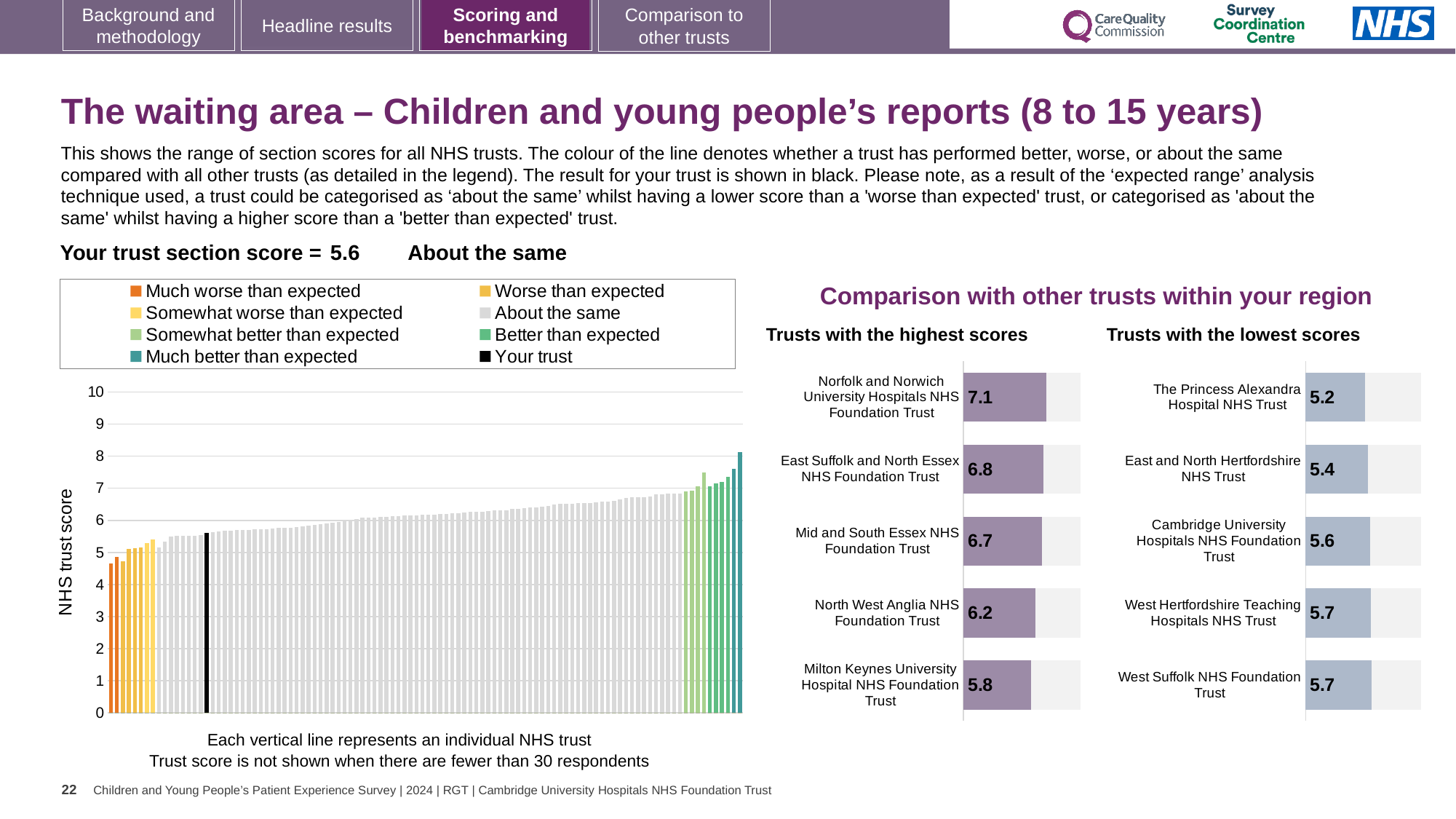
In the 'Trusts with the highest scores' chart, what is the score for Norfolk and Norwich University Hospitals NHS Foundation Trust? 7.1 How many trusts are shown in the 'Trusts with the highest scores' chart? 5 In the 'Trusts with the highest scores' chart, what is the difference between the scores of Norfolk and Norwich University Hospitals NHS Foundation Trust and Milton Keynes University Hospital NHS Foundation Trust? 1.3 In the large chart on the left, do the NHS trust scores rise or fall from left to right? Rise What kind of chart is the large chart on the left showing NHS trust scores? Bar chart What is the y-axis label of the large chart on the left? NHS trust score In the 'Trusts with the highest scores' chart, which has the higher score: East Suffolk and North Essex NHS Foundation Trust or Mid and South Essex NHS Foundation Trust? East Suffolk and North Essex NHS Foundation Trust In the 'Trusts with the lowest scores' chart, which trust has the lowest score? The Princess Alexandra Hospital NHS Trust In the 'Trusts with the lowest scores' chart, what is the difference between the scores of Cambridge University Hospitals NHS Foundation Trust and The Princess Alexandra Hospital NHS Trust? 0.4 In the 'Trusts with the highest scores' chart, which trust has the highest score? Norfolk and Norwich University Hospitals NHS Foundation Trust In the 'Trusts with the lowest scores' chart, what is the score for The Princess Alexandra Hospital NHS Trust? 5.2 How many entries does the legend above the large chart on the left list? 8